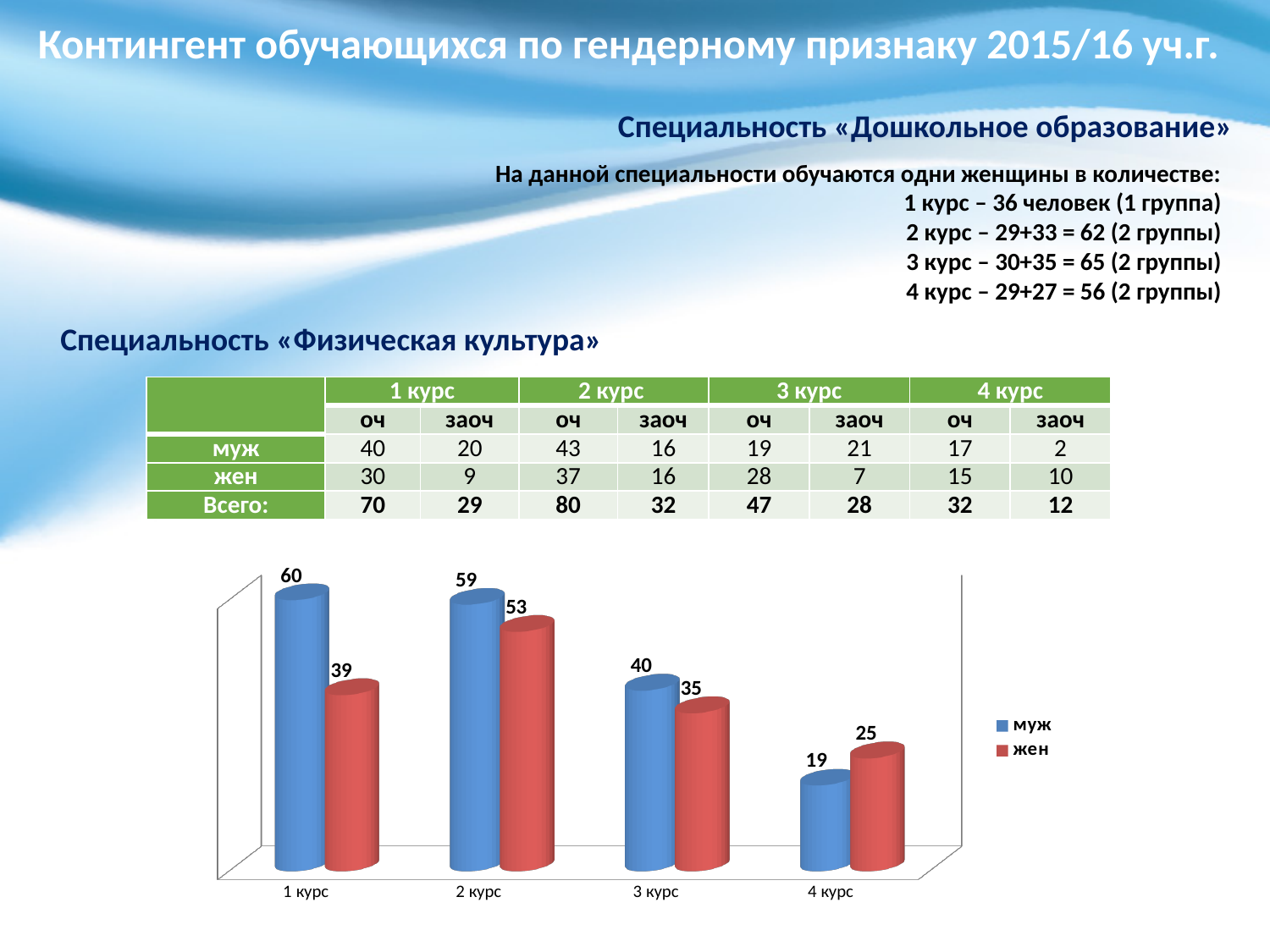
Which is larger in 4 курс, муж or жен? жен How many courses (categories) are shown on the x axis of the chart? 4 Which course has the highest value for муж? 1 курс Which course has the lowest value for жен? 4 курс What kind of chart is shown on the slide? bar chart Do the values for муж rise or fall from 1 курс to 4 курс? fall How many series does the chart legend list? 2 What is the difference between муж and жен in 1 курс? 21 What is the value for муж in 4 курс? 19 What is the value for жен in 3 курс? 35 What is the value for муж in 1 курс? 60 What is the value for жен in 2 курс? 53